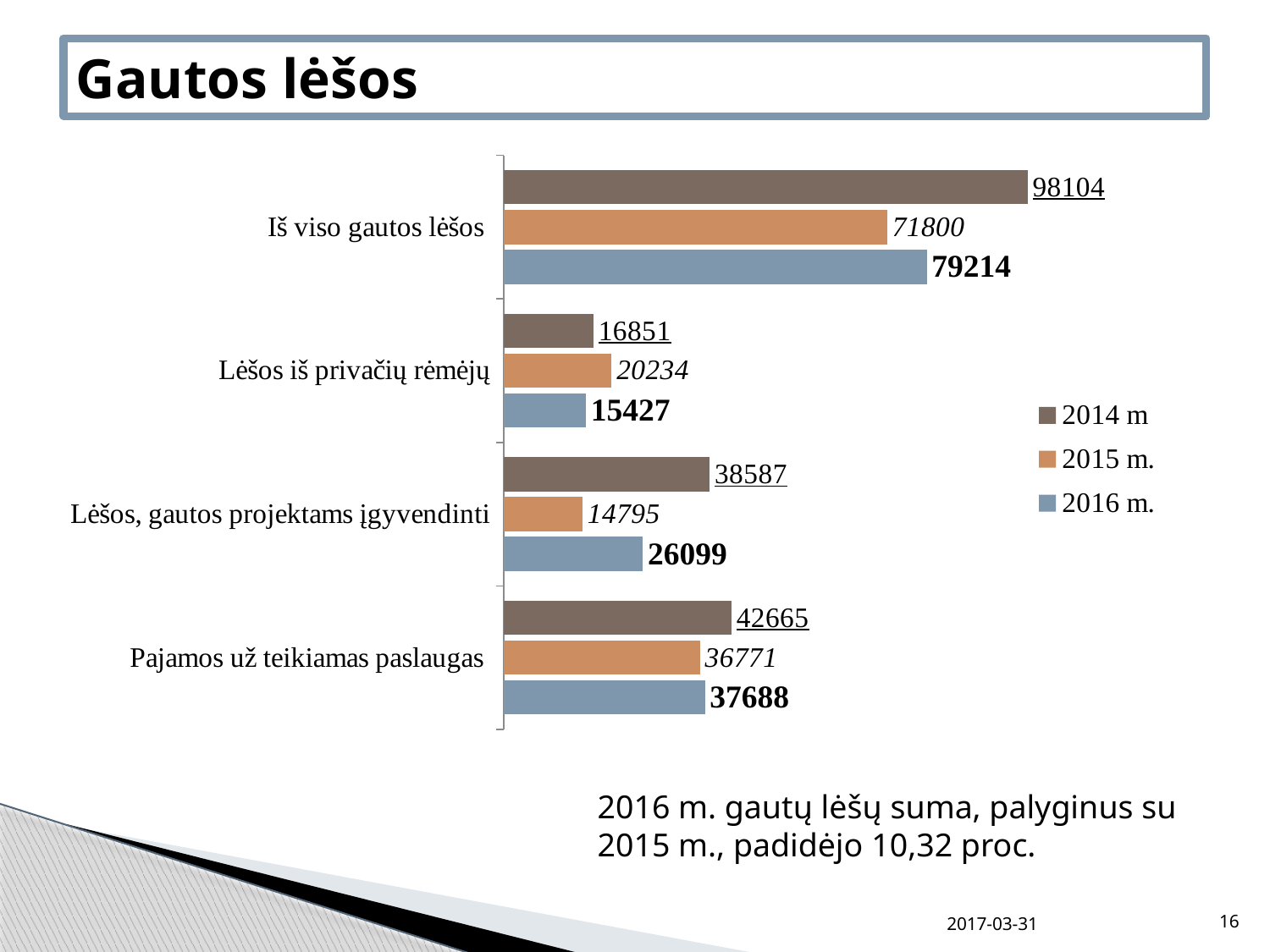
What kind of chart is shown on the slide? Bar chart What is the title of the slide containing the chart? Gautos lėšos For Lėšos, gautos projektams įgyvendinti, which is larger: the 2014 m value or the 2016 m. value? 2014 m Which category has the lowest 2016 m. value? Lėšos iš privačių rėmėjų What is the 2015 m. value for Pajamos už teikiamas paslaugas? 36771 Which category has the highest 2015 m. value? Iš viso gautos lėšos For Lėšos iš privačių rėmėjų, which is larger: the 2015 m. value or the 2014 m value? 2015 m. How many categories are shown on the chart? 4 What is the 2014 m value for Iš viso gautos lėšos? 98104 How many series does the legend list? 3 What is the 2016 m. value for Lėšos, gautos projektams įgyvendinti? 26099 What is the difference between the 2016 m. and 2015 m. values for Iš viso gautos lėšos? 7414